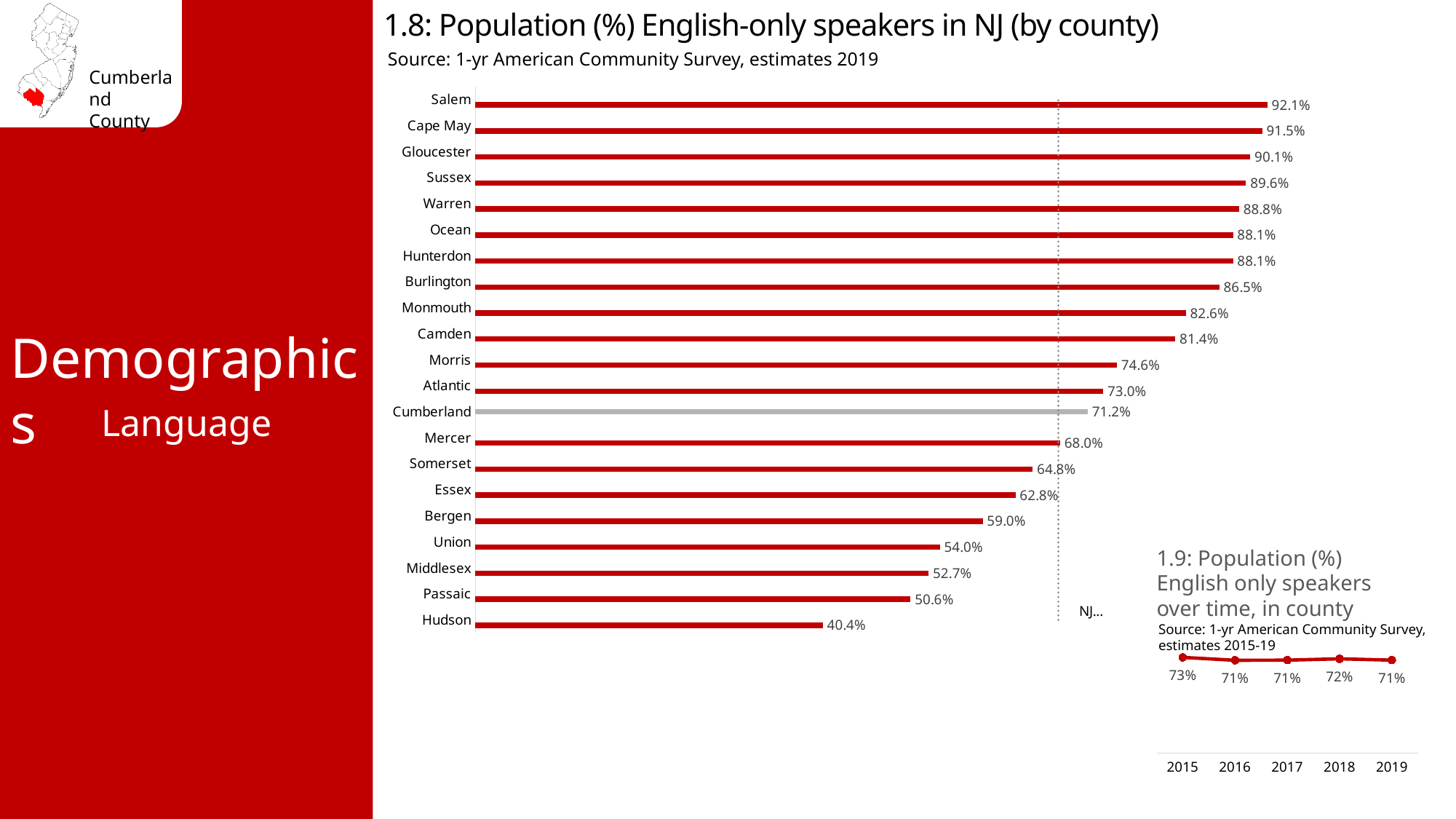
In chart 1.8, what is the value for Cumberland? 71.2% In chart 1.8, which county's bar is coloured grey instead of red? Cumberland In chart 1.8, which is larger, the value for Morris or the value for Atlantic? Morris In chart 1.8, what is the value for Hudson? 40.4% In chart 1.9, what is the value for 2015? 73% In chart 1.8, what is the difference between the values for Salem and Hudson? 51.7% What kind of chart is chart 1.9? Line chart In chart 1.8, which county has the highest percentage of English-only speakers? Salem In chart 1.8, how many counties are shown? 21 In chart 1.8, which county has the lowest percentage of English-only speakers? Hudson In chart 1.9, how many years are plotted? 5 What kind of chart is chart 1.8? Bar chart